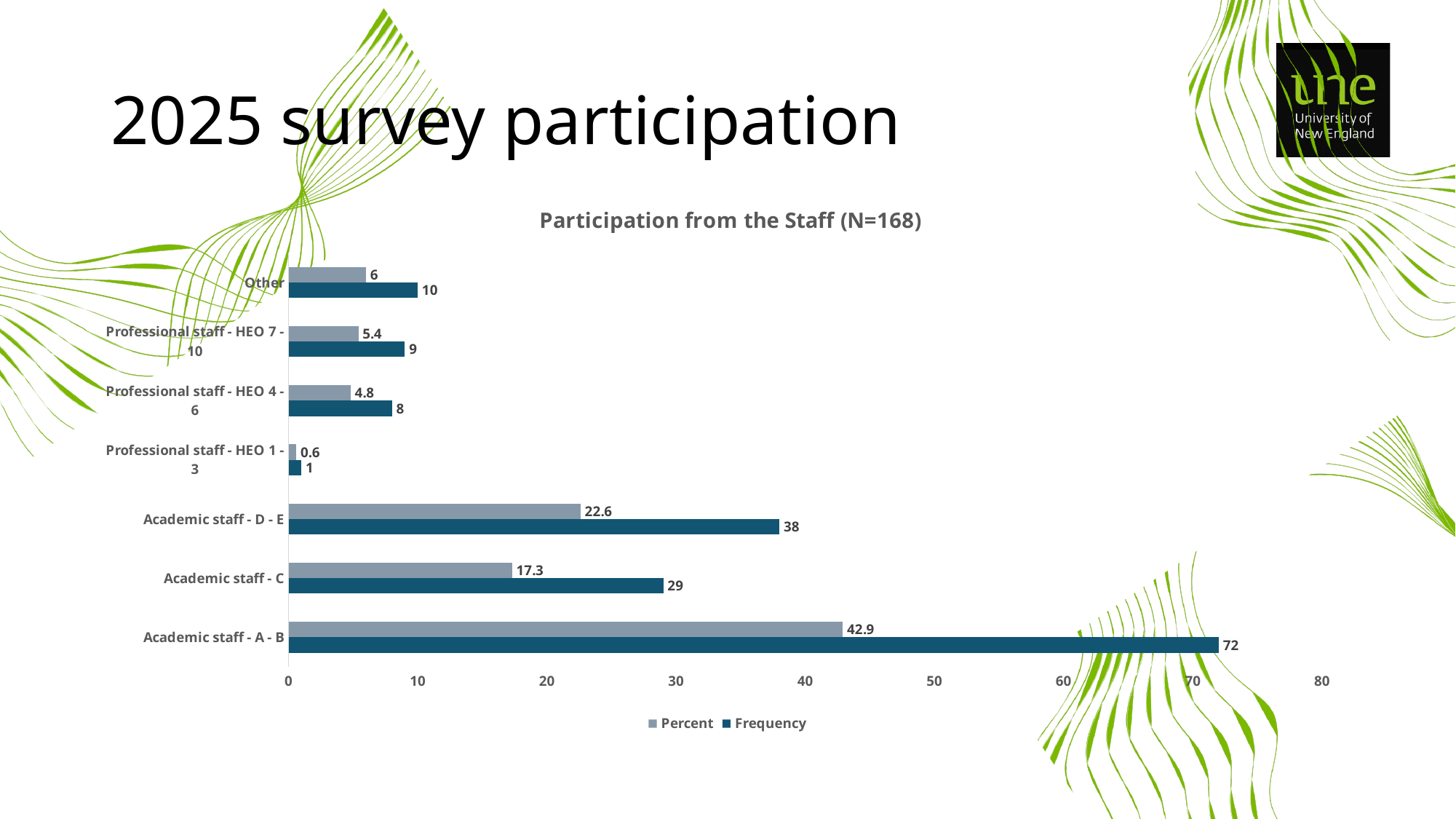
Which category has the highest Frequency? Academic staff - A - B Which category has the lowest Percent? Professional staff - HEO 1 - 3 How many categories are shown on the chart? 7 What is the title of the chart? Participation from the Staff (N=168) What is the Percent value for Other? 6 What is the Percent value for Academic staff - D - E? 22.6 What kind of chart is shown on the slide? Bar chart What is the Frequency value for Professional staff - HEO 7 - 10? 9 What is the difference in Frequency between Academic staff - D - E and Academic staff - C? 9 Which has a larger Frequency, Other or Professional staff - HEO 4 - 6? Other How many series does the legend list? 2 What is the Frequency value for Academic staff - A - B? 72